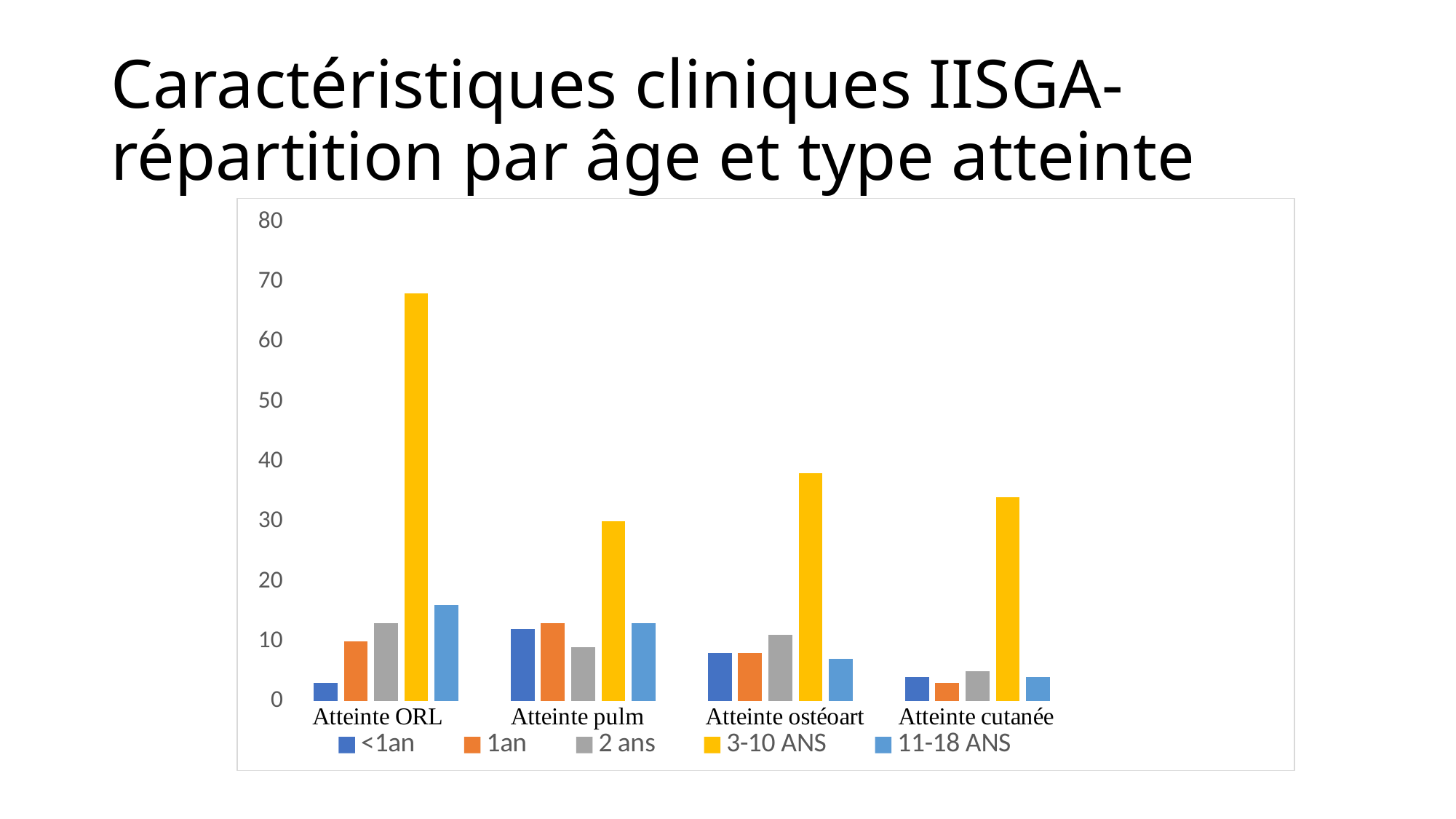
Is the value for 3-10 ANS in Atteinte ostéoart greater or less than 30? greater In which category is the 3-10 ANS bar the highest? Atteinte ORL Which series has the lowest bar in the Atteinte ORL category? <1an Is the value for 11-18 ANS in Atteinte ORL greater or less than 20? less Which colour represents the 3-10 ANS series in the legend? yellow Is the value for 3-10 ANS in Atteinte pulm greater or less than 40? less Which series has the highest bar in the Atteinte ORL category? 3-10 ANS What kind of chart is shown on the slide? bar chart Which is larger: the 3-10 ANS value for Atteinte ORL or for Atteinte pulm? Atteinte ORL How many series does the legend list? 5 How many categories (types of atteinte) are shown on the x axis? 4